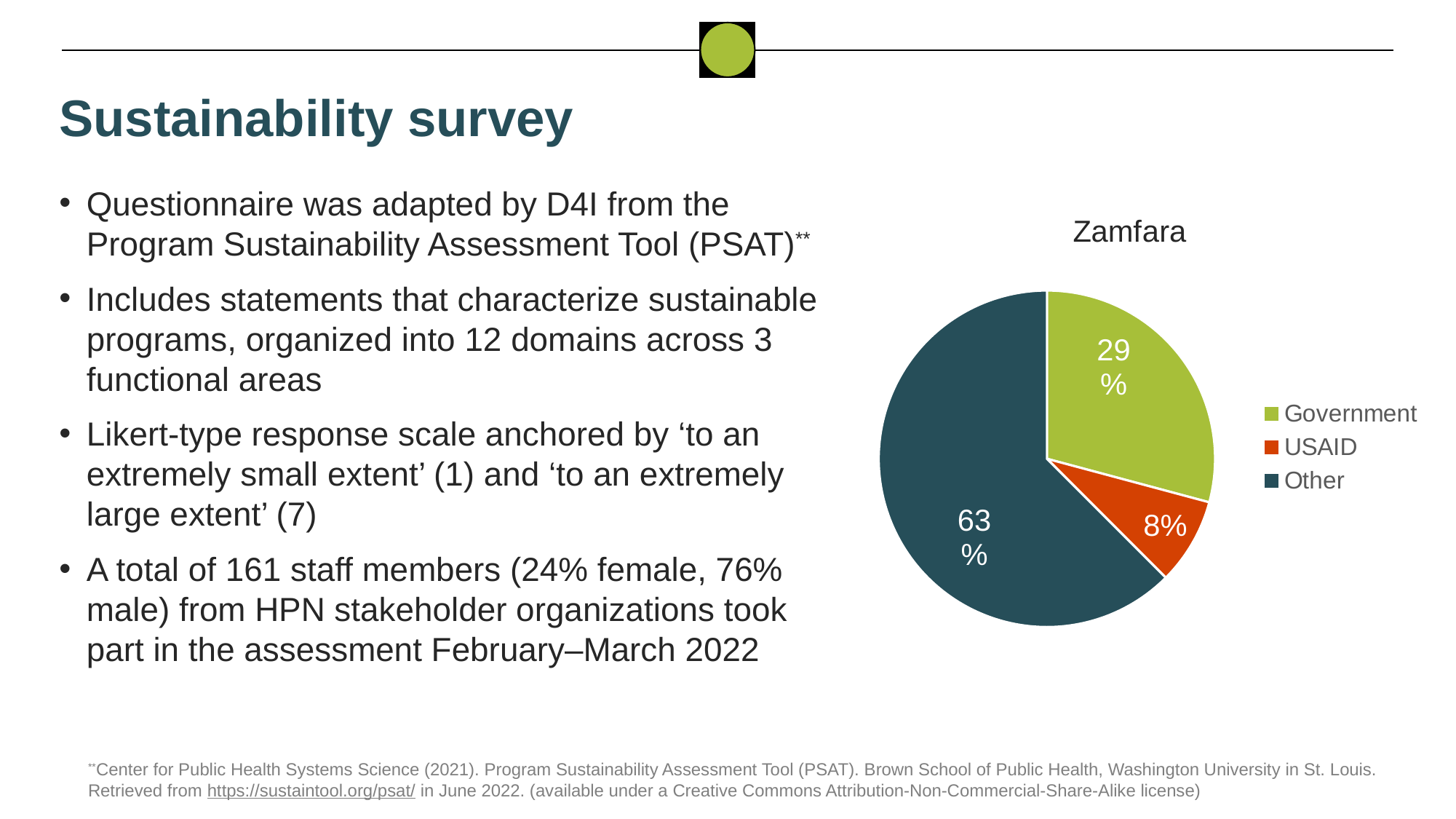
What share of the pie does USAID represent? 8% Which category has the smallest slice of the pie? USAID How many categories does the legend list? 3 Which is larger, the Government slice or the USAID slice? Government What is the difference in percentage points between Government and USAID? 21 What share of the pie does Government represent? 29% What share of the pie does Other represent? 63% What is the difference in percentage points between Other and Government? 34 What colour is the Other slice in the pie chart? dark teal What is the title of the chart? Zamfara What type of chart is shown on the slide? pie chart Which category has the largest slice of the pie? Other